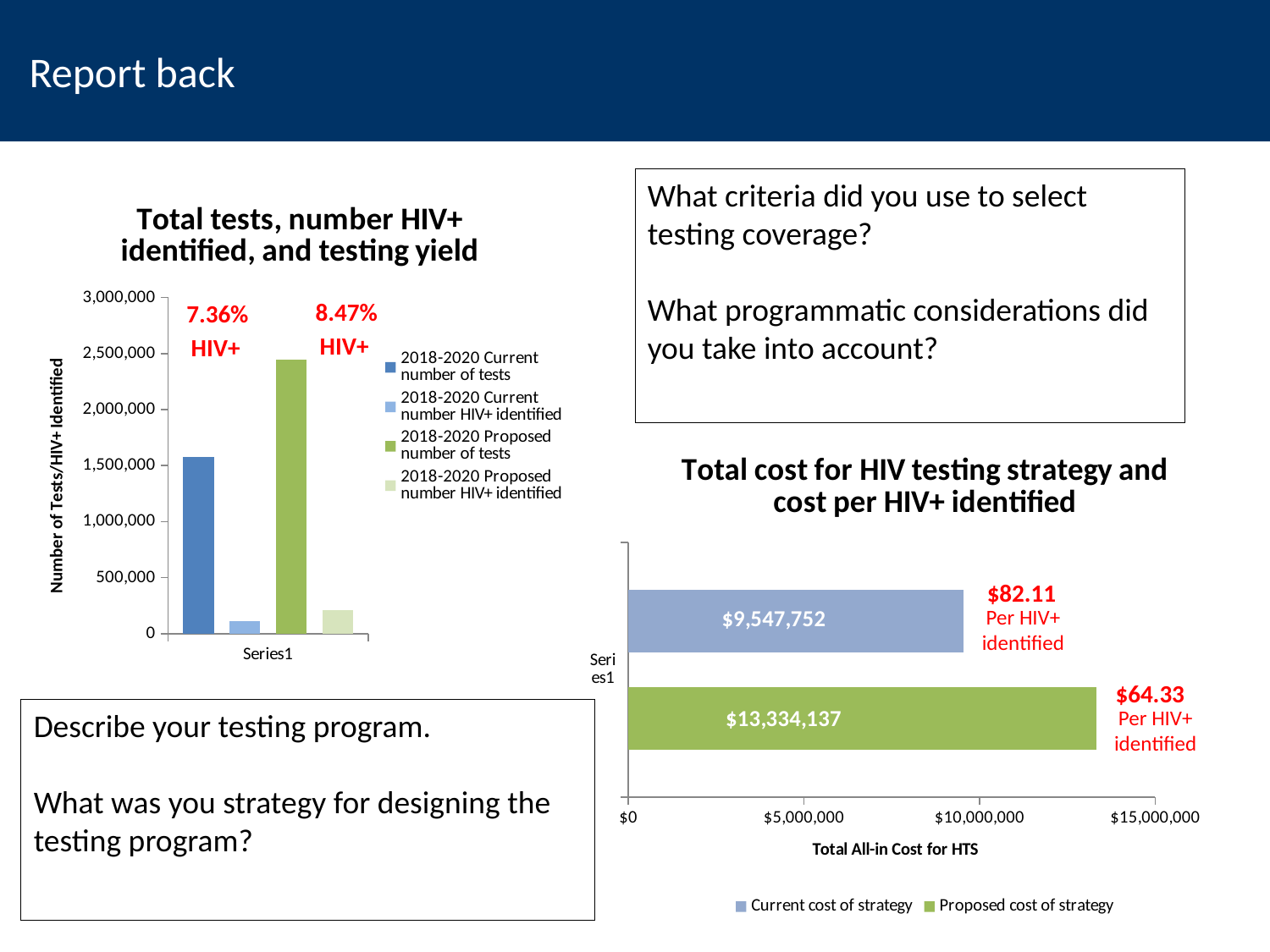
In the 'Total tests, number HIV+ identified, and testing yield' chart, is the value for 2018-2020 Proposed number of tests greater or less than 2,000,000? greater In the 'Total cost for HIV testing strategy and cost per HIV+ identified' chart, what is the cost per HIV+ identified for the proposed strategy? $64.33 In the 'Total cost for HIV testing strategy and cost per HIV+ identified' chart, what is the proposed cost of strategy? $13,334,137 In the 'Total cost for HIV testing strategy and cost per HIV+ identified' chart, how much larger is the proposed cost of strategy than the current cost of strategy? $3,786,385 In the 'Total cost for HIV testing strategy and cost per HIV+ identified' chart, which is larger: the current cost of strategy or the proposed cost of strategy? Proposed cost of strategy In the 'Total tests, number HIV+ identified, and testing yield' chart, which series has the shortest bar? 2018-2020 Current number HIV+ identified In the 'Total tests, number HIV+ identified, and testing yield' chart, what testing yield is shown for the proposed strategy? 8.47% HIV+ In the 'Total tests, number HIV+ identified, and testing yield' chart, which series has the tallest bar? 2018-2020 Proposed number of tests What kind of chart is 'Total cost for HIV testing strategy and cost per HIV+ identified'? Bar chart In the 'Total cost for HIV testing strategy and cost per HIV+ identified' chart, how many series does the legend list? 2 In the 'Total tests, number HIV+ identified, and testing yield' chart, how many series does the legend list? 4 In the 'Total cost for HIV testing strategy and cost per HIV+ identified' chart, what is the current cost of strategy? $9,547,752